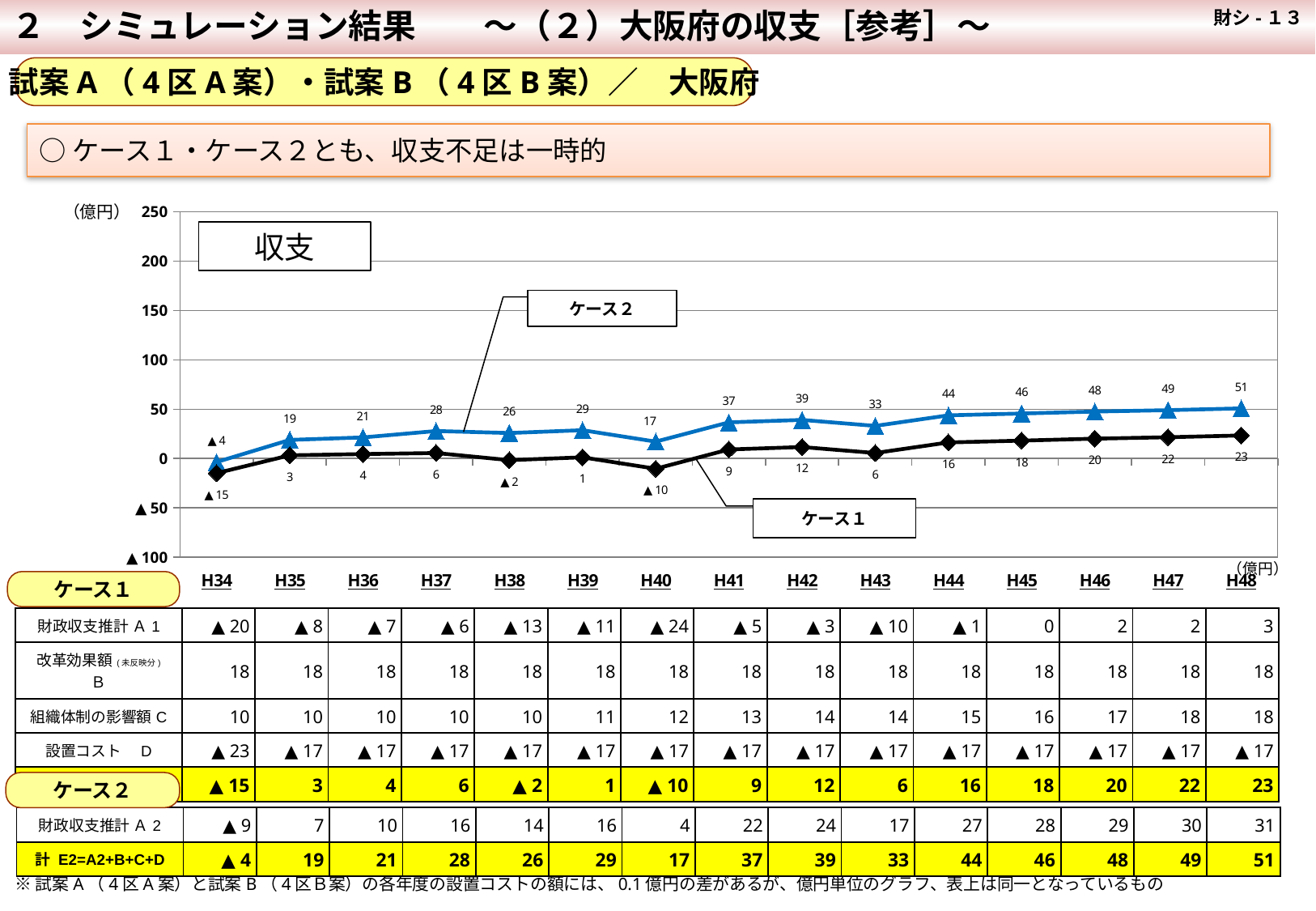
What kind of chart is the 収支 chart? line chart What is the value for ケース1 at H40 in the 収支 chart? ▲10 At H48, how much larger is the ケース2 value than the ケース1 value in the 収支 chart? 28 Is the value for ケース2 at H44 greater or less than 50 in the 収支 chart? less What is the title shown in the box at the top of the chart? 収支 In which year does ケース2 reach its highest value in the 収支 chart? H48 How many years are plotted along the x axis of the 収支 chart? 15 How many series are plotted in the 収支 chart? 2 What is the value for ケース2 at H41 in the 収支 chart? 37 In which year does ケース1 have its lowest value in the 収支 chart? H34 At H37, which series has the larger value in the 収支 chart, ケース1 or ケース2? ケース2 Do the ケース2 values rise or fall from H44 to H48 in the 収支 chart? rise